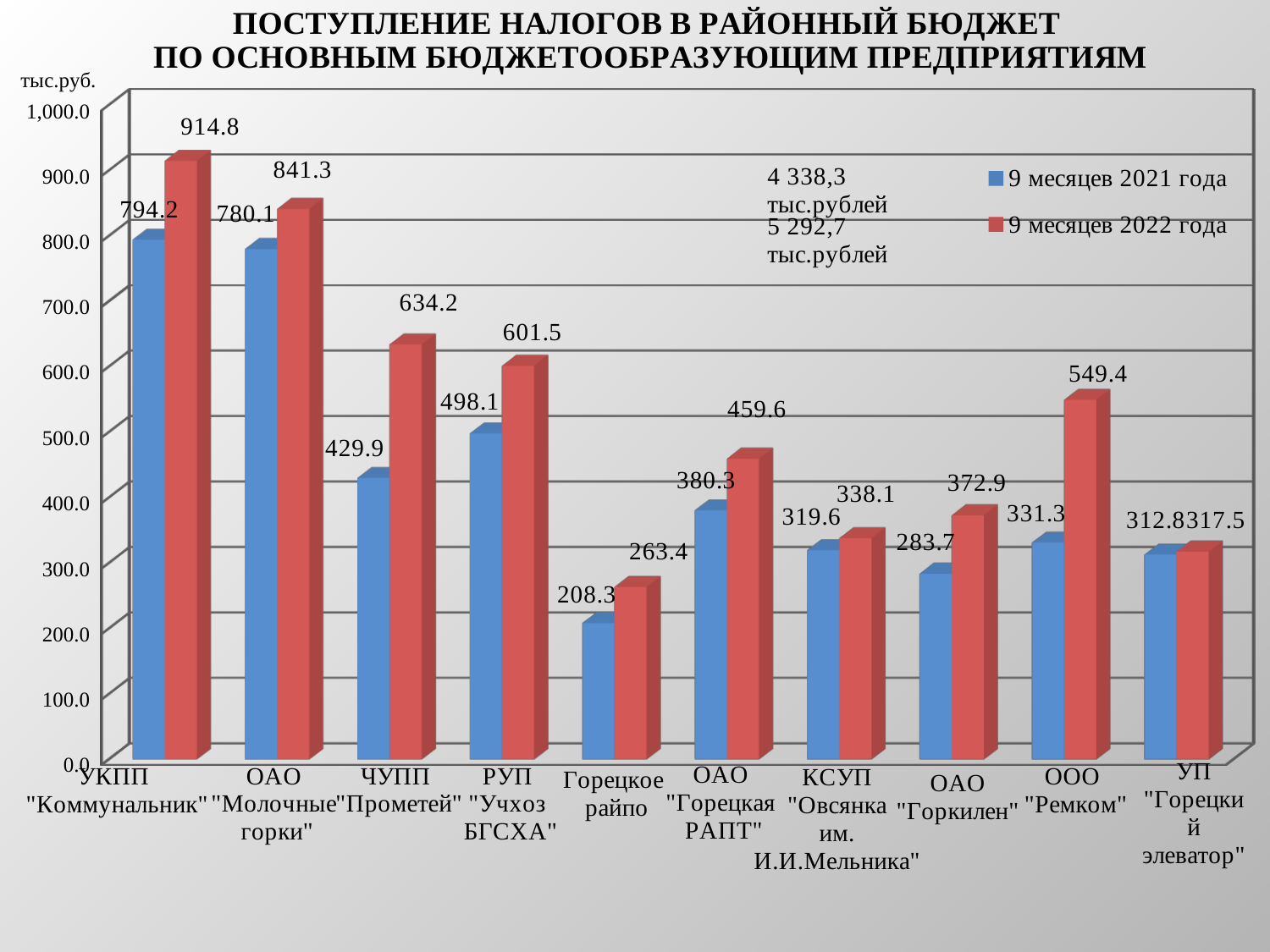
What is the value for УКПП "Коммунальник" in the series 9 месяцев 2022 года? 914.8 Which is larger: the 9 месяцев 2021 года value for РУП "Учхоз БГСХА" or the 9 месяцев 2021 года value for ЧУПП "Прометей"? РУП "Учхоз БГСХА" How many series does the legend list? 2 Which category has the lowest value in the series 9 месяцев 2022 года? Горецкое райпо What kind of chart is shown on the slide? Bar chart What is the difference between the 9 месяцев 2022 года and 9 месяцев 2021 года values for ЧУПП "Прометей"? 204.3 What is the value for Горецкое райпо in the series 9 месяцев 2022 года? 263.4 What unit is shown on the vertical axis label? тыс.руб. What is the value for ООО "Ремком" in the series 9 месяцев 2021 года? 331.3 What is the difference between the 9 месяцев 2022 года and 9 месяцев 2021 года values for ООО "Ремком"? 218.1 Which category has the highest value in the series 9 месяцев 2021 года? УКПП "Коммунальник" How many categories (enterprises) are shown on the x axis? 10